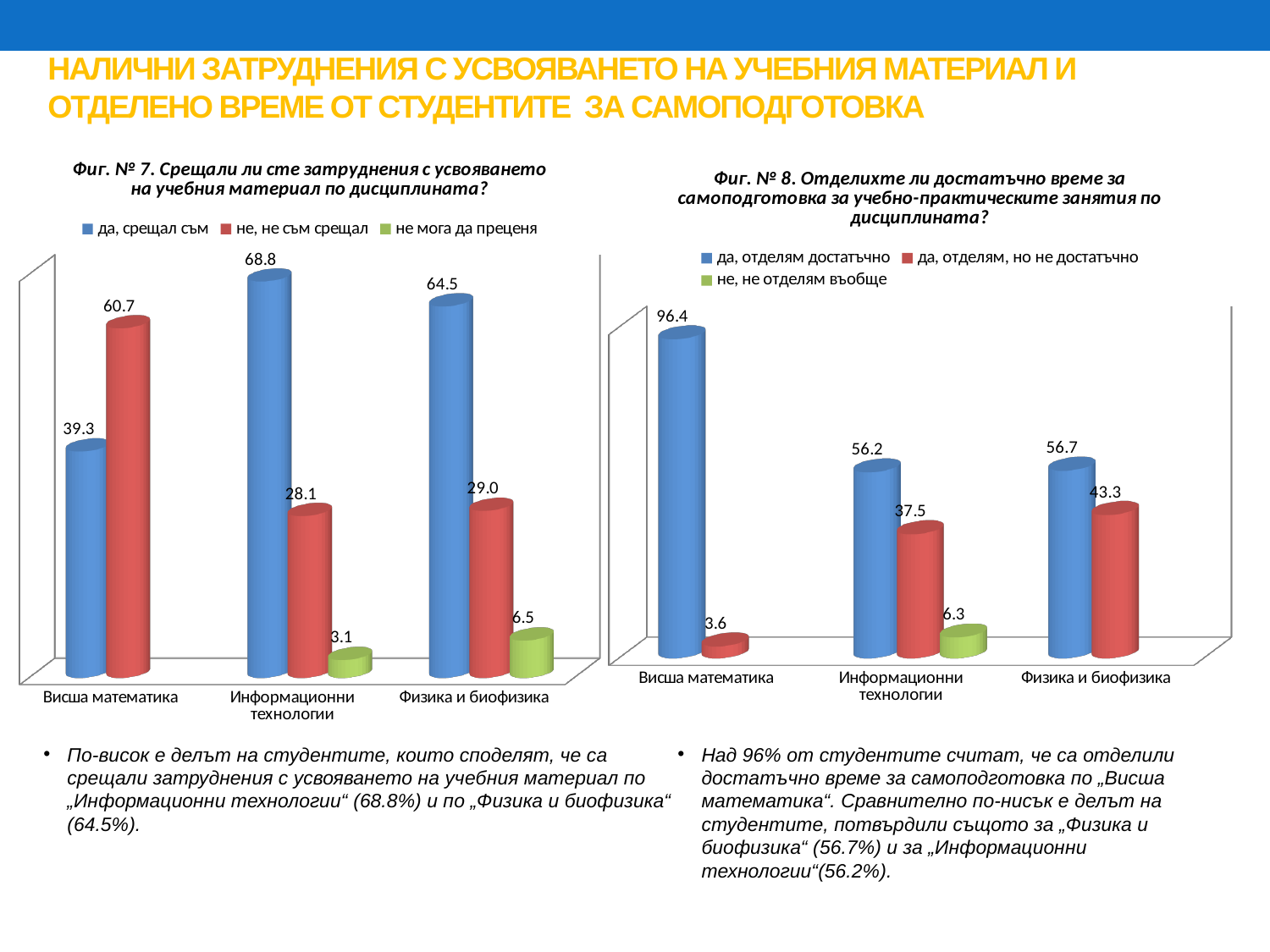
In the chart titled Фиг. № 8, what is the value for "да, отделям достатъчно" for Висша математика? 96.4 What kind of chart is the chart titled Фиг. № 8? bar chart In the chart titled Фиг. № 8, which category has the lowest value for "да, отделям, но не достатъчно"? Висша математика In the chart titled Фиг. № 7, how many series does the legend list? 3 In the chart titled Фиг. № 7, what is the difference between the "да, срещал съм" values for Информационни технологии and Физика и биофизика? 4.3 In the chart titled Фиг. № 7, which category has the highest value for "да, срещал съм"? Информационни технологии In the chart titled Фиг. № 8, how many categories are shown on the x axis? 3 In the chart titled Фиг. № 8, what is the difference between the "да, отделям достатъчно" values for Висша математика and Информационни технологии? 40.2 In the chart titled Фиг. № 8, what is the value for "да, отделям, но не достатъчно" for Физика и биофизика? 43.3 In the chart titled Фиг. № 7, what is the value for "не, не съм срещал" for Висша математика? 60.7 In the chart titled Фиг. № 7, which is larger for Висша математика: "да, срещал съм" or "не, не съм срещал"? не, не съм срещал In the chart titled Фиг. № 7, what is the value for "да, срещал съм" for Информационни технологии? 68.8